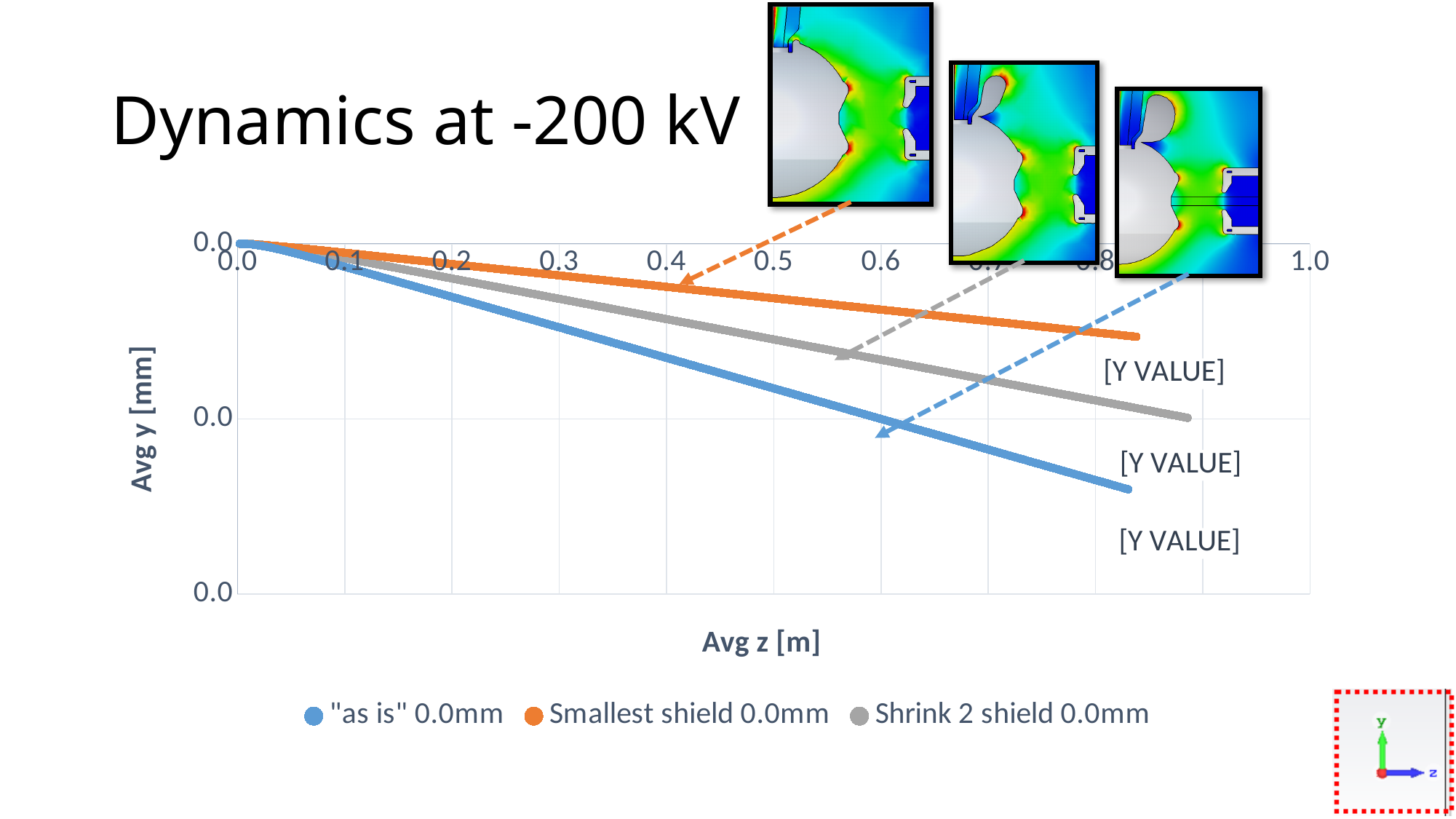
Which series has the lowest Avg y at the right end of the lines? "as is" 0.0mm What is the label of the chart's y axis? Avg y [mm] At the right end of the lines, which series has the larger Avg y: "as is" 0.0mm or Shrink 2 shield 0.0mm? Shrink 2 shield 0.0mm What is the largest value shown on the chart's x axis? 1.0 Which series has the highest Avg y at the right end of the lines? Smallest shield 0.0mm Do the plotted lines rise or fall as Avg z increases along the x axis? fall How many series does the chart legend list? 3 What kind of chart is shown on the slide? line chart What is the label of the chart's x axis? Avg z [m] At the right end of the lines, which series has the larger Avg y: Smallest shield 0.0mm or Shrink 2 shield 0.0mm? Smallest shield 0.0mm